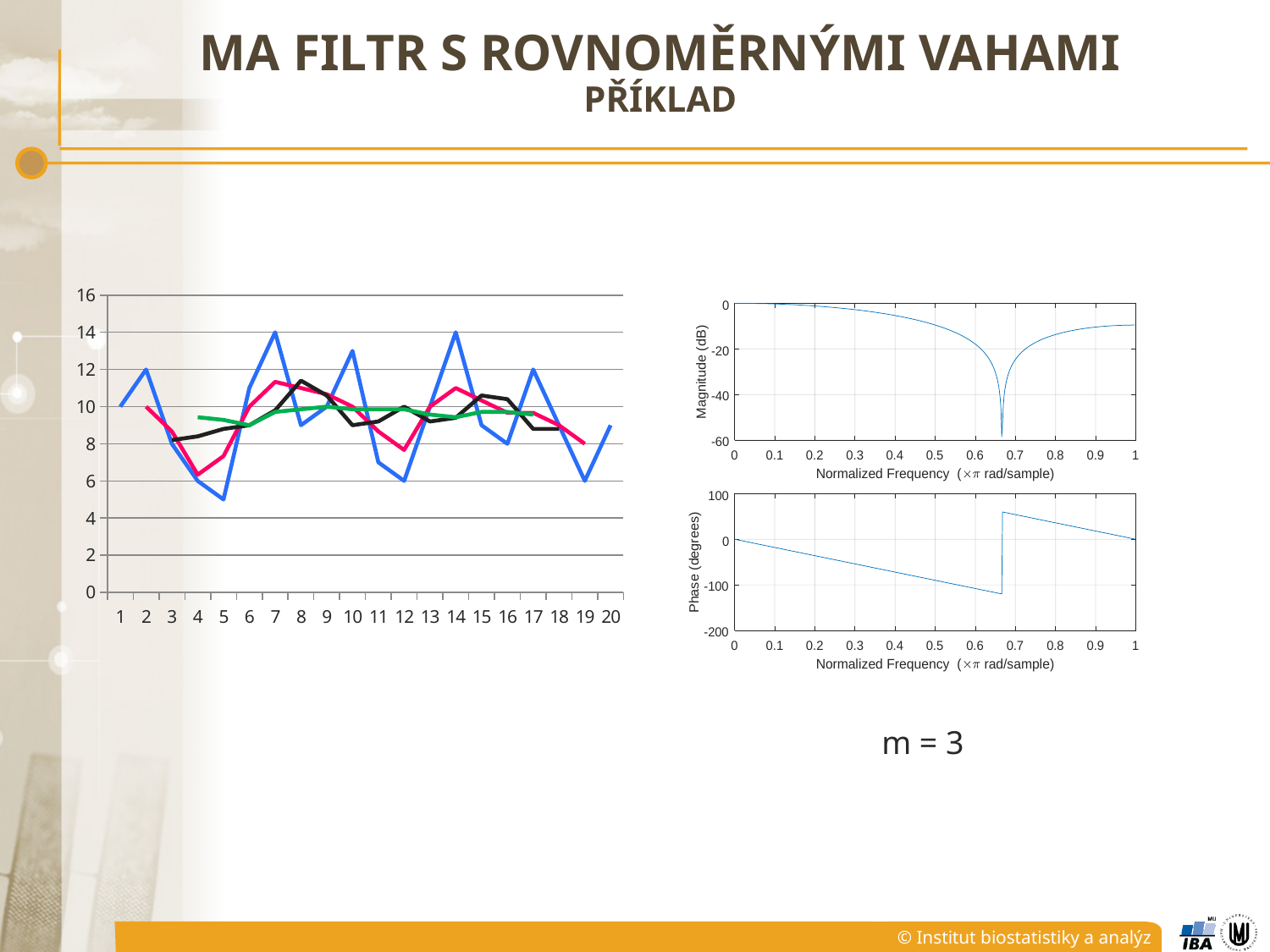
In the chart on the left, at which x value does the blue line reach its lowest point? 5 In the Phase (degrees) chart on the right, is the phase at normalized frequency 0.6 greater or less than 0? less In the Magnitude (dB) chart on the right, is the magnitude at normalized frequency 0.1 greater or less than -20? greater In the chart on the left, how many categories are shown on the x axis? 20 In the chart on the left, which line is larger at x = 7, the blue line or the green line? blue line In the chart on the left, is the value of the green line at x = 4 greater or less than 8? greater In the chart on the left, how many coloured lines are plotted? 4 In the chart on the left, what is the highest value shown on the y axis? 16 What kind of chart is the chart on the left of the slide? line chart In the chart on the left, which line is larger at x = 5, the red line or the blue line? red line